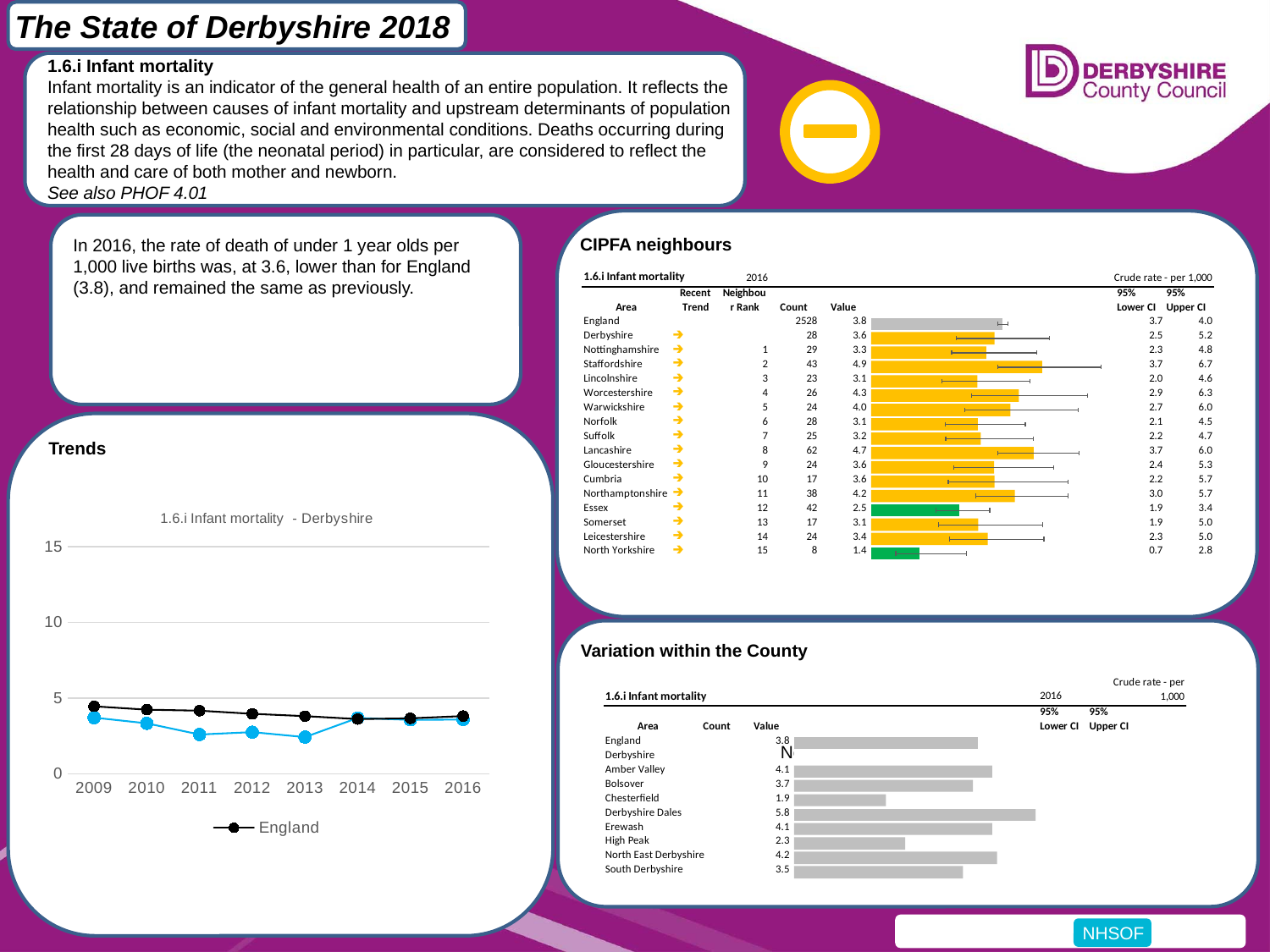
In the Variation within the County chart, what is the value for Derbyshire Dales? 5.8 In the Variation within the County chart, what is the difference between the values for Derbyshire Dales and Chesterfield? 3.9 In the CIPFA neighbours chart, what is the difference between the values for Staffordshire and Derbyshire? 1.3 What kind of chart is the Trends chart (1.6.i Infant mortality - Derbyshire)? line chart In the Trends chart, is the value for England in 2009 greater or less than 5? less In the CIPFA neighbours chart, which area has the lowest value? North Yorkshire In the Variation within the County chart, which area has the lowest value? Chesterfield In the Trends chart, how many years are plotted along the x axis? 8 In the CIPFA neighbours chart, what is the count for Lancashire? 62 In the CIPFA neighbours chart, what is the value for Staffordshire? 4.9 In the CIPFA neighbours chart, which area has the highest value? Staffordshire In the Variation within the County chart, which is larger, the value for Bolsover or the value for South Derbyshire? Bolsover